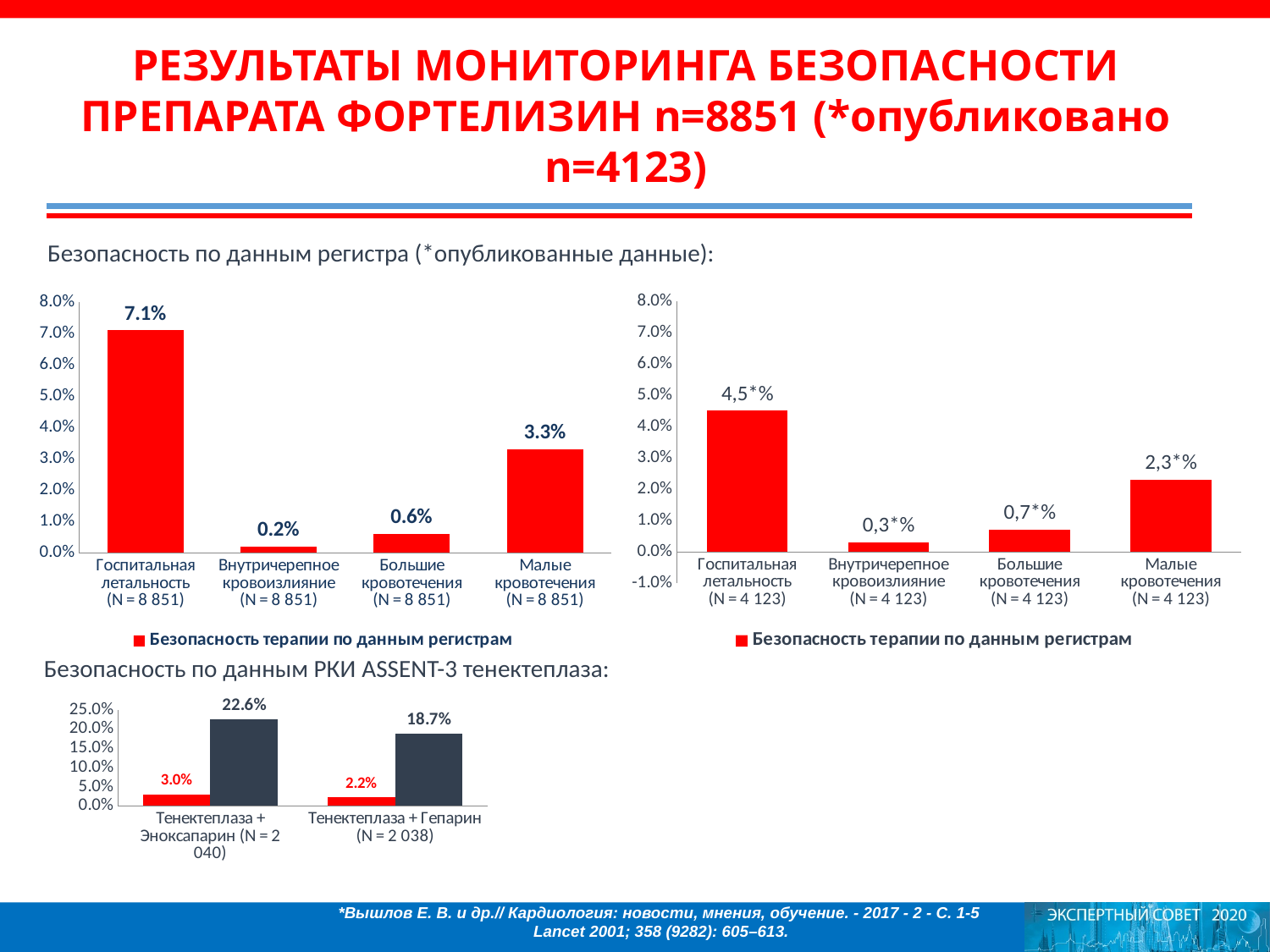
In the top-left chart (N = 8 851), what is the difference between Госпитальная летальность and Малые кровотечения? 3.8% In the top-left chart (N = 8 851), which category has the lowest value? Внутричерепное кровоизлияние What is the legend entry shown under the top-left chart (N = 8 851)? Безопасность терапии по данным регистрам In the bottom-left chart (ASSENT-3), what is the value of the dark bar for Тенектеплаза + Гепарин (N = 2 038)? 18.7% In the top-left chart (N = 8 851), what is the value for Госпитальная летальность? 7.1% In the top-right chart (N = 4 123), which is larger: Большие кровотечения or Внутричерепное кровоизлияние? Большие кровотечения In the top-left chart (N = 8 851), how many categories are shown? 4 In the top-right chart (N = 4 123), which category has the highest value? Госпитальная летальность What type of chart is the top-right chart (N = 4 123)? Bar chart In the bottom-left chart (ASSENT-3), what is the value of the red bar for Тенектеплаза + Эноксапарин (N = 2 040)? 3.0% In the top-right chart (N = 4 123), what is the value for Малые кровотечения? 2,3*% In the bottom-left chart (ASSENT-3), what is the difference between the dark bars for Тенектеплаза + Эноксапарин and Тенектеплаза + Гепарин? 3.9%